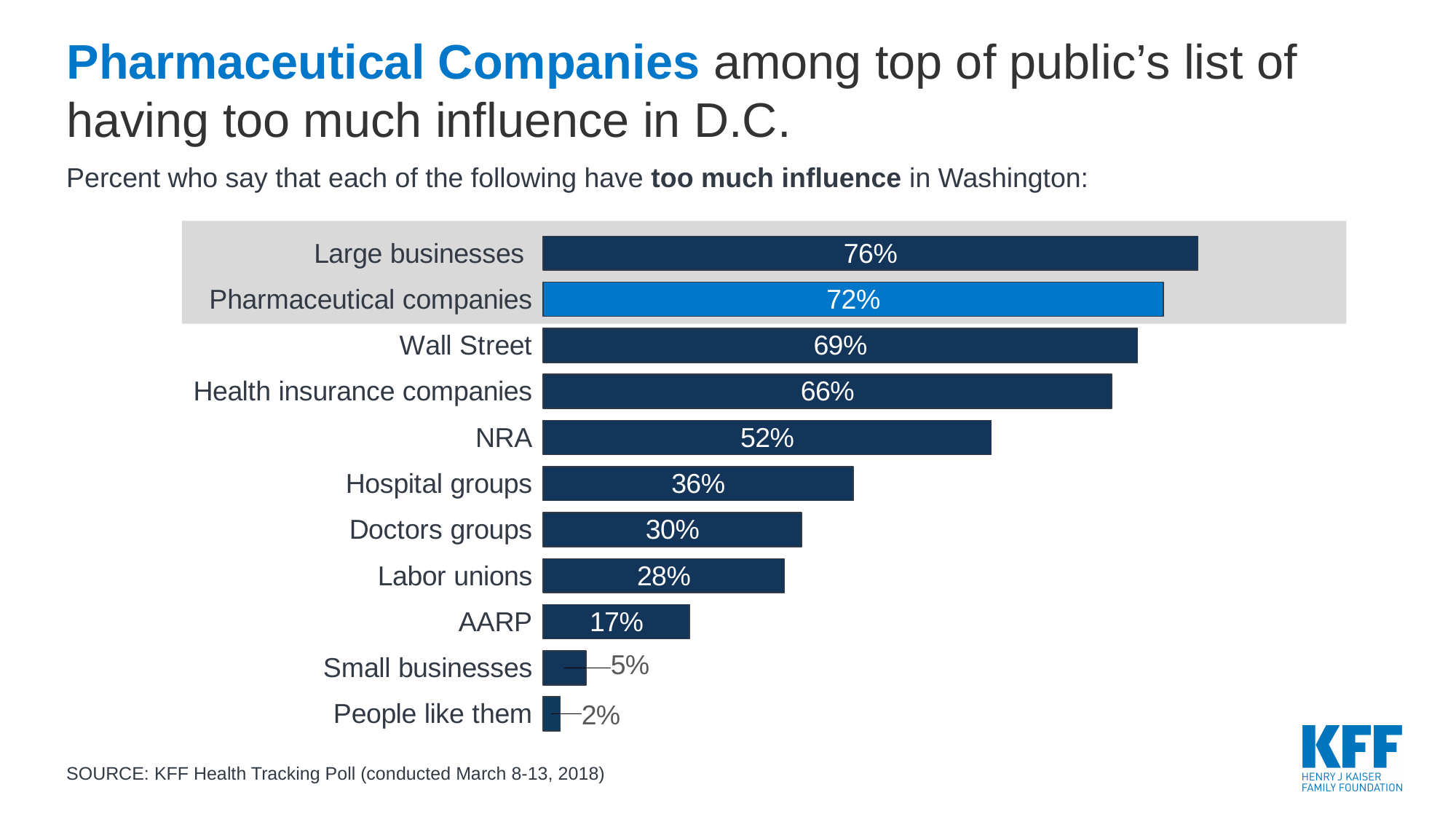
Which bar is highlighted in a lighter blue colour than the others? Pharmaceutical companies What is the difference between the values for hospital groups and doctors groups? 6 percentage points Which has a higher value, Wall Street or health insurance companies? Wall Street How many categories are shown on the chart? 11 Which category has the highest value on the chart? Large businesses Which category has the lowest value on the chart? People like them What is the difference between the values for large businesses and pharmaceutical companies? 4 percentage points What kind of chart is shown on the slide? Bar chart What percent say labor unions have too much influence? 28% What is the value shown for the NRA? 52% Which has a higher value, AARP or small businesses? AARP What percent say pharmaceutical companies have too much influence in Washington? 72%